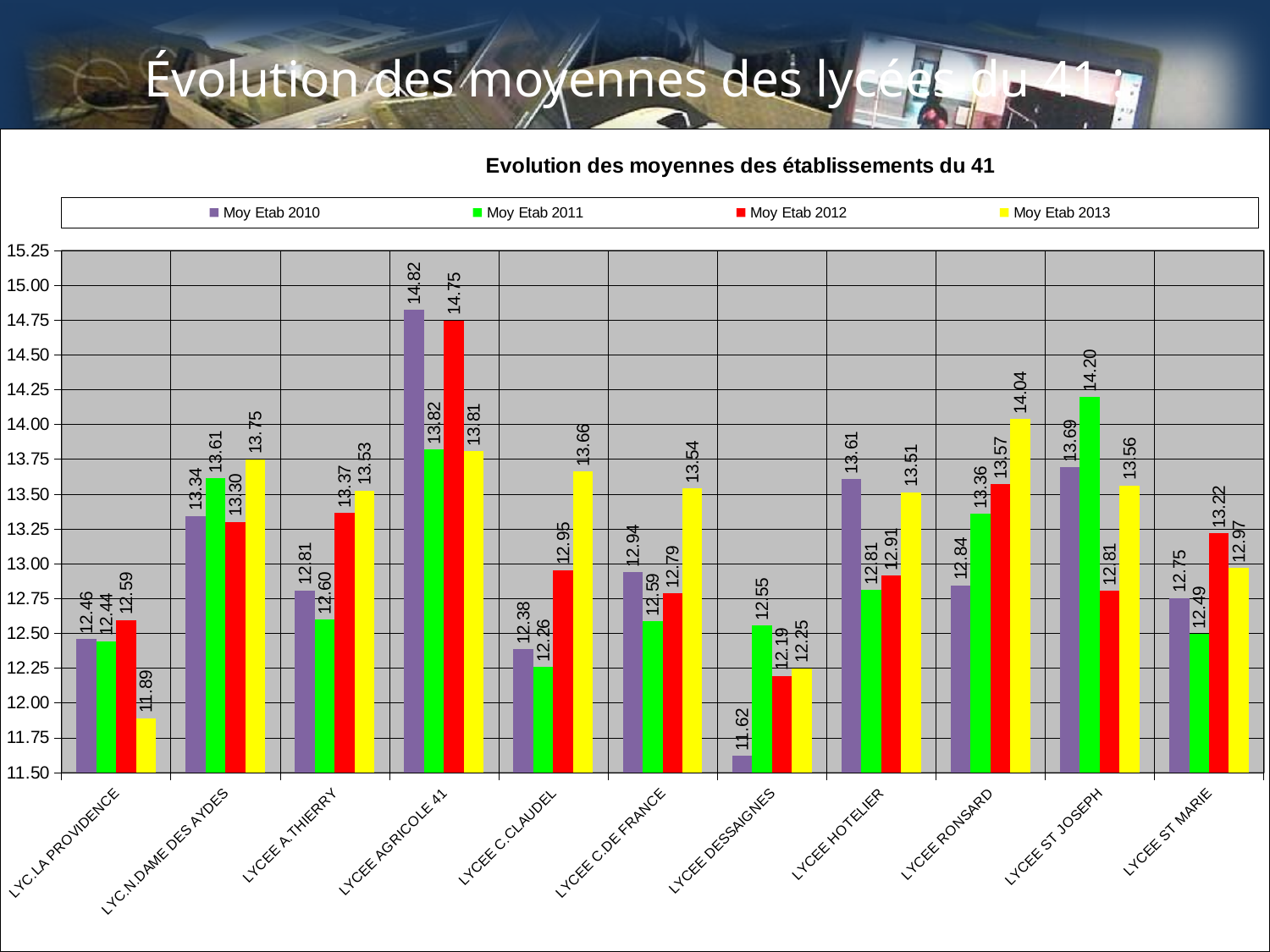
What is the Moy Etab 2012 value for LYCEE C.CLAUDEL? 12.95 What kind of chart is shown? bar chart Which colour represents Moy Etab 2012 in the legend? red Which establishment has the highest Moy Etab 2011 value? LYCEE ST JOSEPH What is the Moy Etab 2010 value for LYCEE AGRICOLE 41? 14.82 How many establishments are shown on the x axis? 11 What is the Moy Etab 2013 value for LYCEE RONSARD? 14.04 Which establishment has the lowest Moy Etab 2010 value? LYCEE DESSAIGNES Is the Moy Etab 2013 value for LYC. LA PROVIDENCE greater or less than 12.00? less How many series does the legend list? 4 For LYCEE HOTELIER, which is larger: the Moy Etab 2010 value or the Moy Etab 2013 value? Moy Etab 2010 What is the difference between the Moy Etab 2013 and Moy Etab 2010 values for LYCEE C.CLAUDEL? 1.28